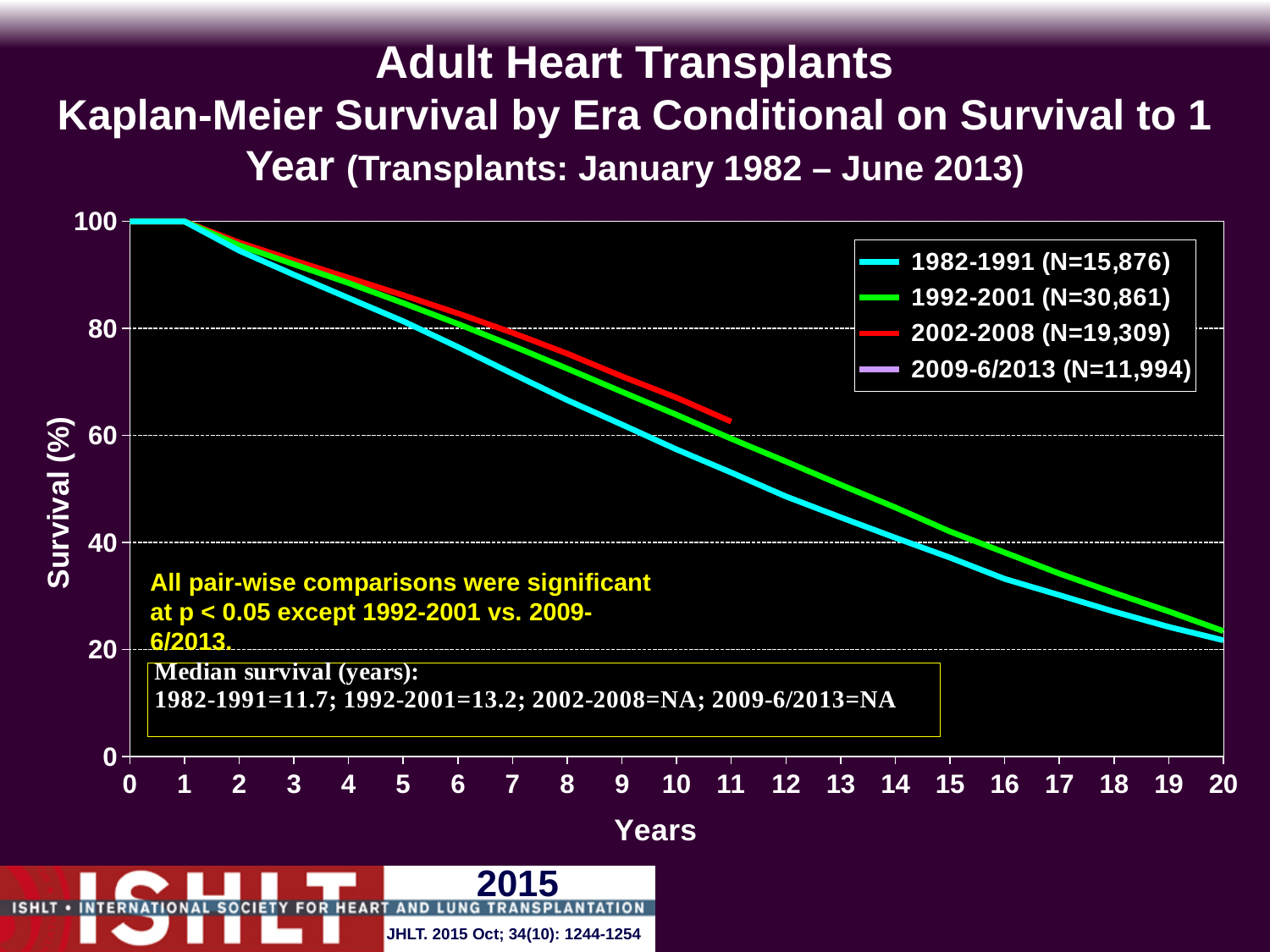
What is the median survival in years for the 1992-2001 era, as stated on the slide? 13.2 What is the median survival in years for the 1982-1991 era, as stated on the slide? 11.7 What is the label of the x axis? Years According to the legend, what is the N for the 2009-6/2013 era? 11,994 Is the survival value for the 1982-1991 era at 15 years greater or less than 40? less At 10 years, which era has the higher survival: 1982-1991 or 1992-2001? 1992-2001 Do the survival curves rise or fall as the years increase along the x axis? fall Is the survival value for the 1982-1991 era at 10 years greater or less than 60? less Is the survival value for the 2002-2008 era at 11 years greater or less than 60? greater How many series does the legend list? 4 What kind of chart is shown on the slide? line chart According to the legend, what is the N for the 1982-1991 era? 15,876